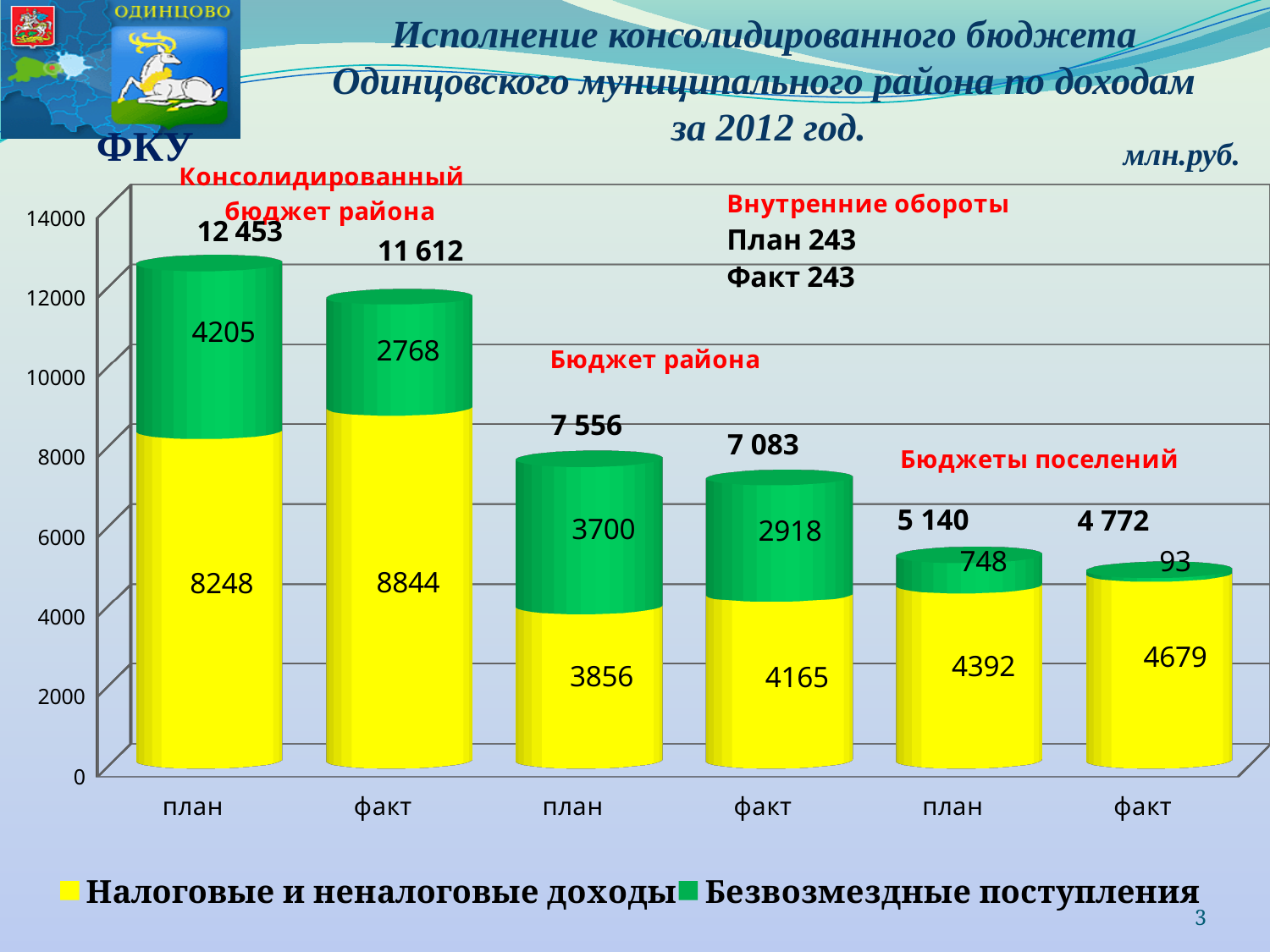
How many series does the legend list? 2 What is the total shown above the план bar of Бюджеты поселений? 5 140 Which is larger: Безвозмездные поступления for the план bar of Консолидированный бюджет района or for the план bar of Бюджет района? план, Консолидированный бюджет района What is the total shown above the факт bar of Консолидированный бюджет района? 11 612 What is the value of Безвозмездные поступления for the факт bar of Бюджеты поселений? 93 Which bar has the highest total value? план, Консолидированный бюджет района What is the value of Безвозмездные поступления for the факт bar of Бюджет района? 2918 Which bar has the lowest total value? факт, Бюджеты поселений How many bars are plotted in the chart? 6 What is the value of Налоговые и неналоговые доходы for the план bar of Консолидированный бюджет района? 8248 What kind of chart is shown on the slide? stacked bar chart What is the difference between the Налоговые и неналоговые доходы values of the факт and план bars of Бюджет района? 309